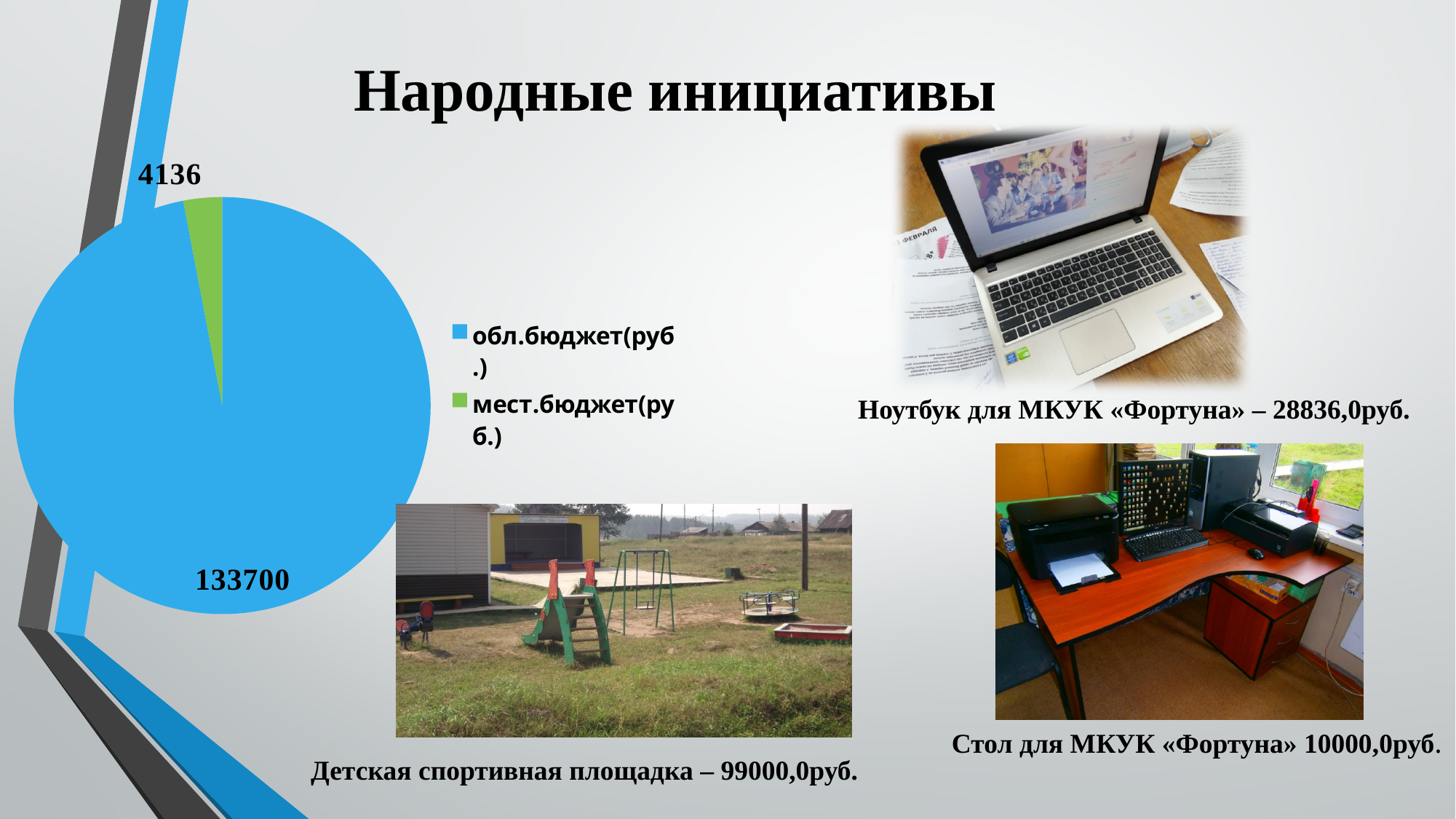
What is the total of the two values shown in the pie chart? 137836 What is the difference between the values for обл.бюджет(руб.) and мест.бюджет(руб.) in the pie chart? 129564 What colour is the slice for мест.бюджет(руб.) in the pie chart? green What is the value for мест.бюджет(руб.) in the pie chart? 4136 Which is larger in the pie chart: обл.бюджет(руб.) or мест.бюджет(руб.)? обл.бюджет(руб.) Which category has the smallest slice in the pie chart? мест.бюджет(руб.) How many slices does the pie chart have? 2 What share of the pie chart does мест.бюджет(руб.) represent, to the nearest whole percent? 3% What kind of chart is shown on the slide? pie chart How many entries does the legend of the pie chart list? 2 What is the value for обл.бюджет(руб.) in the pie chart? 133700 Which category has the largest slice in the pie chart? обл.бюджет(руб.)